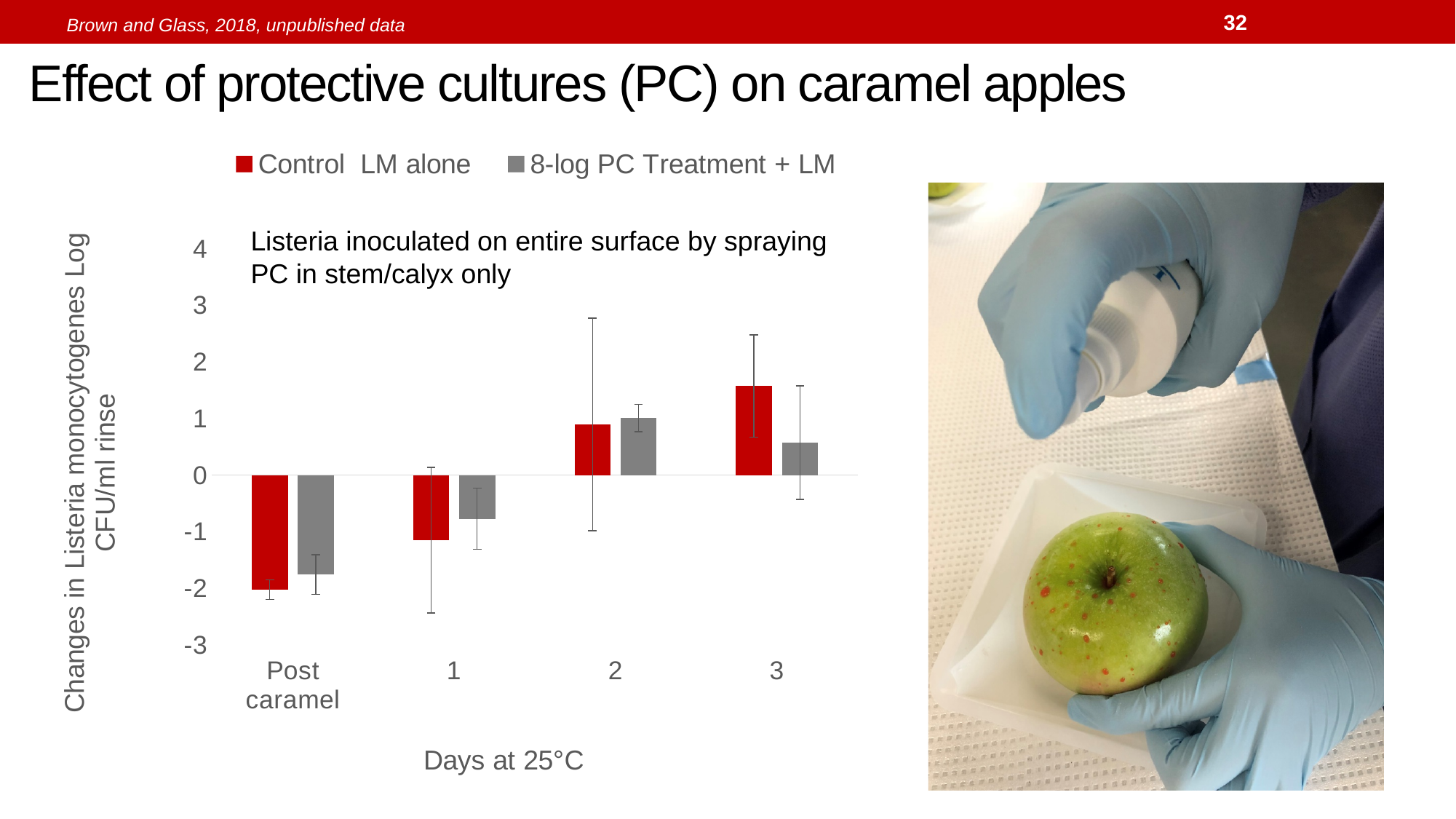
Is the Control LM alone value at Post caramel greater or less than -1? less What kind of chart is shown on the slide? bar chart Which category has the lowest value for the Control LM alone series? Post caramel How many categories are shown along the x axis of the chart? 4 At day 3, which series has the larger value: Control LM alone or 8-log PC Treatment + LM? Control LM alone Is the 8-log PC Treatment + LM value at day 3 greater or less than 1? less What is the title of the x axis of the chart? Days at 25°C Do the Control LM alone values rise or fall from Post caramel to day 3? rise Is the 8-log PC Treatment + LM value at day 1 greater or less than -1? greater How many series does the chart legend list? 2 Which category has the highest value for the Control LM alone series? 3